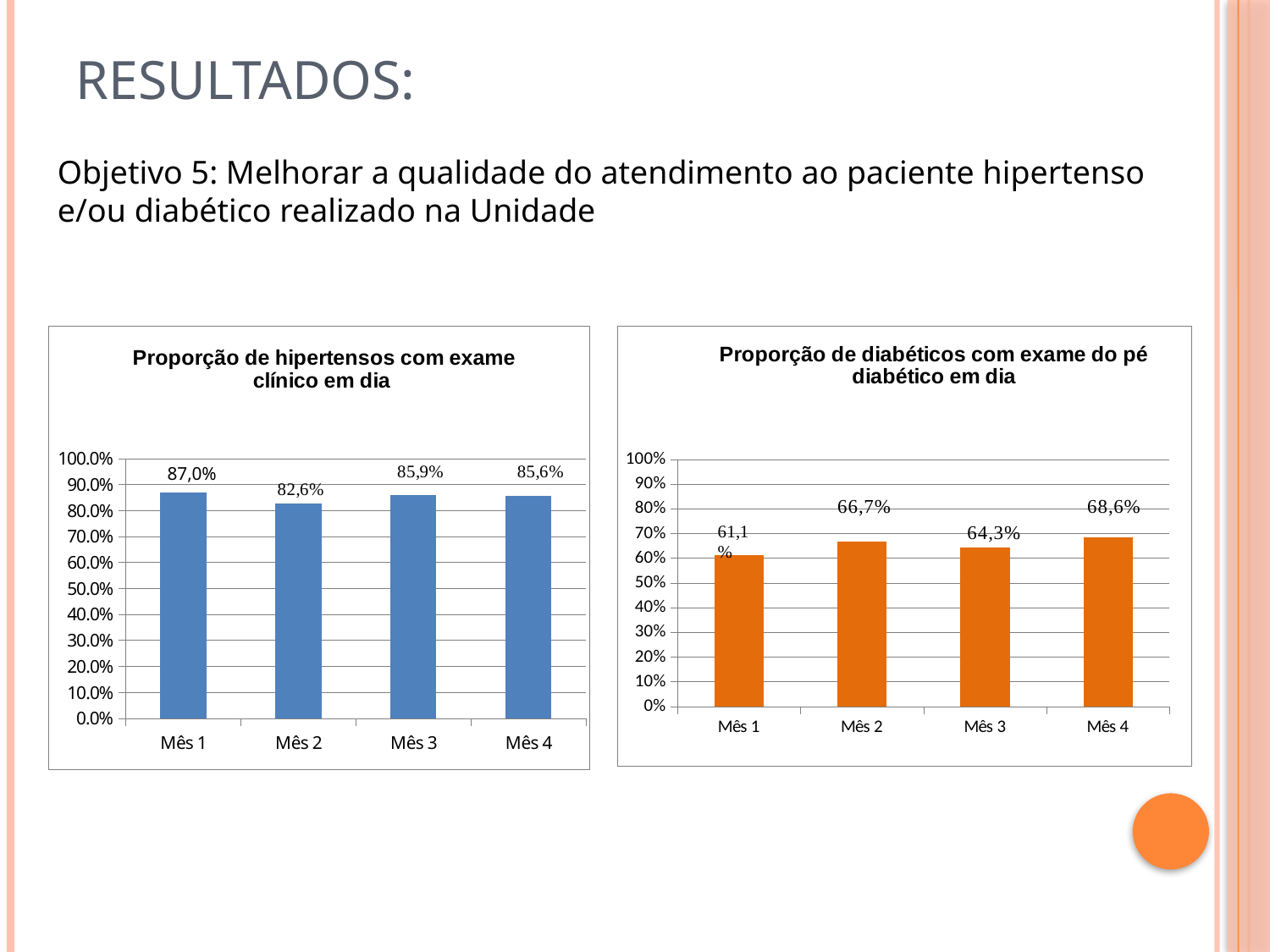
What colour are the bars in the chart on the right, 'Proporção de diabéticos com exame do pé diabético em dia'? Orange In the chart 'Proporção de diabéticos com exame do pé diabético em dia', what is the value for Mês 3? 64,3% In the chart 'Proporção de hipertensos com exame clínico em dia', which month has the highest value? Mês 1 In the chart 'Proporção de diabéticos com exame do pé diabético em dia', which month has the lowest value? Mês 1 What kind of chart is 'Proporção de hipertensos com exame clínico em dia'? Bar chart In the chart 'Proporção de hipertensos com exame clínico em dia', what is the value for Mês 2? 82,6% How many months are shown in the chart 'Proporção de diabéticos com exame do pé diabético em dia'? 4 In the chart 'Proporção de diabéticos com exame do pé diabético em dia', which is larger, the value for Mês 2 or Mês 3? Mês 2 In the chart 'Proporção de diabéticos com exame do pé diabético em dia', what is the difference between the values for Mês 4 and Mês 1? 7,5 percentage points In the chart 'Proporção de hipertensos com exame clínico em dia', is the value for Mês 3 greater or less than 80.0%? greater In the chart 'Proporção de hipertensos com exame clínico em dia', what is the difference between the values for Mês 1 and Mês 2? 4,4 percentage points In the chart 'Proporção de diabéticos com exame do pé diabético em dia', which month has the highest value? Mês 4